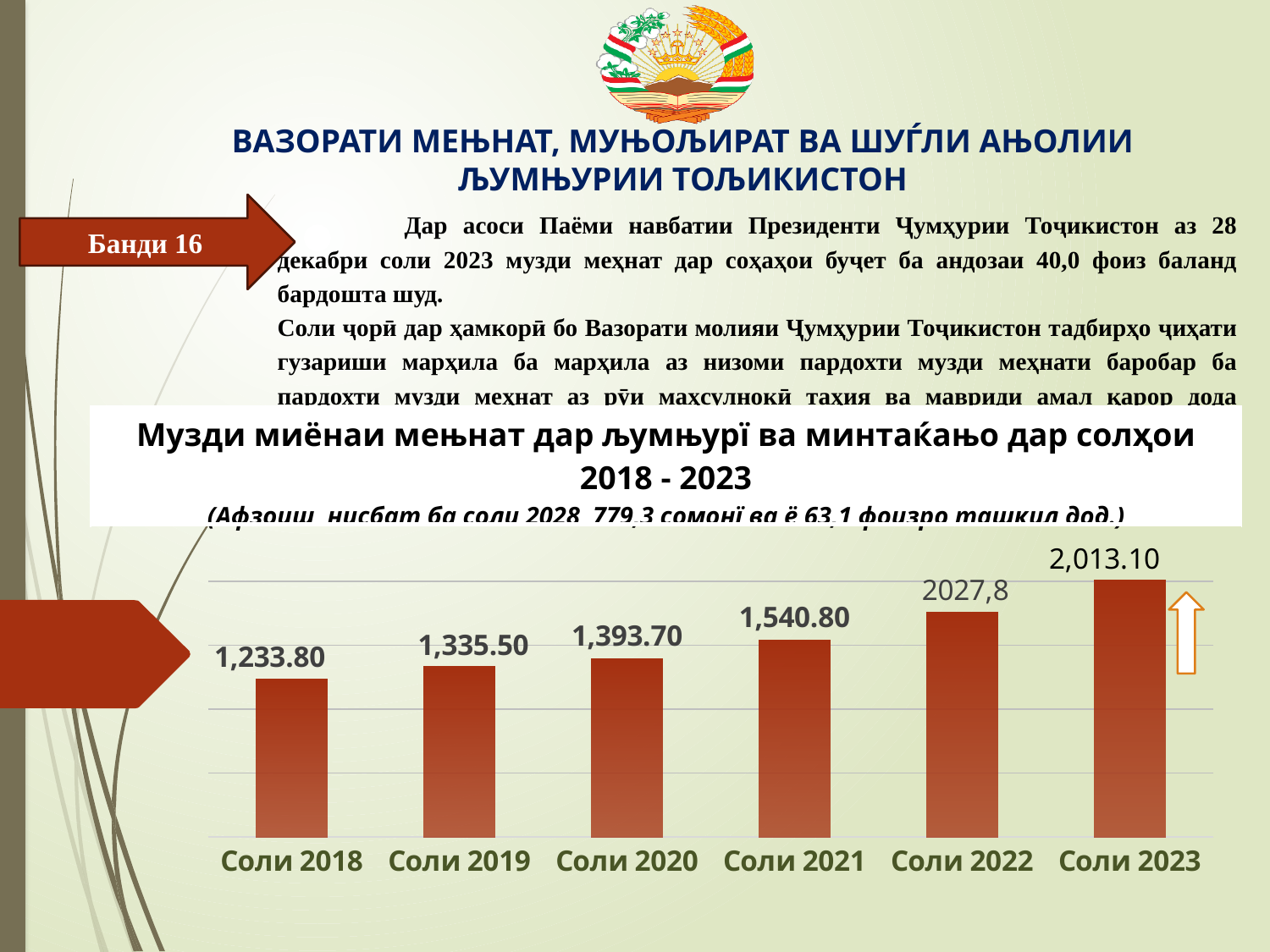
What is the difference between the values for Соли 2023 and Соли 2018? 779.30 What is the value shown for Соли 2020? 1,393.70 What is the value shown for Соли 2021? 1,540.80 What is the value shown for Соли 2023? 2,013.10 Which is larger, the value for Соли 2021 or the value for Соли 2020? Соли 2021 Do the values rise or fall from Соли 2018 to Соли 2023? rise What is the value shown for Соли 2018? 1,233.80 How many years (categories) are plotted in the chart? 6 What type of chart is shown on the slide? bar chart Which year has the lowest value in the chart? Соли 2018 What is the difference between the values for Соли 2021 and Соли 2020? 147.10 What is the value shown for Соли 2019? 1,335.50